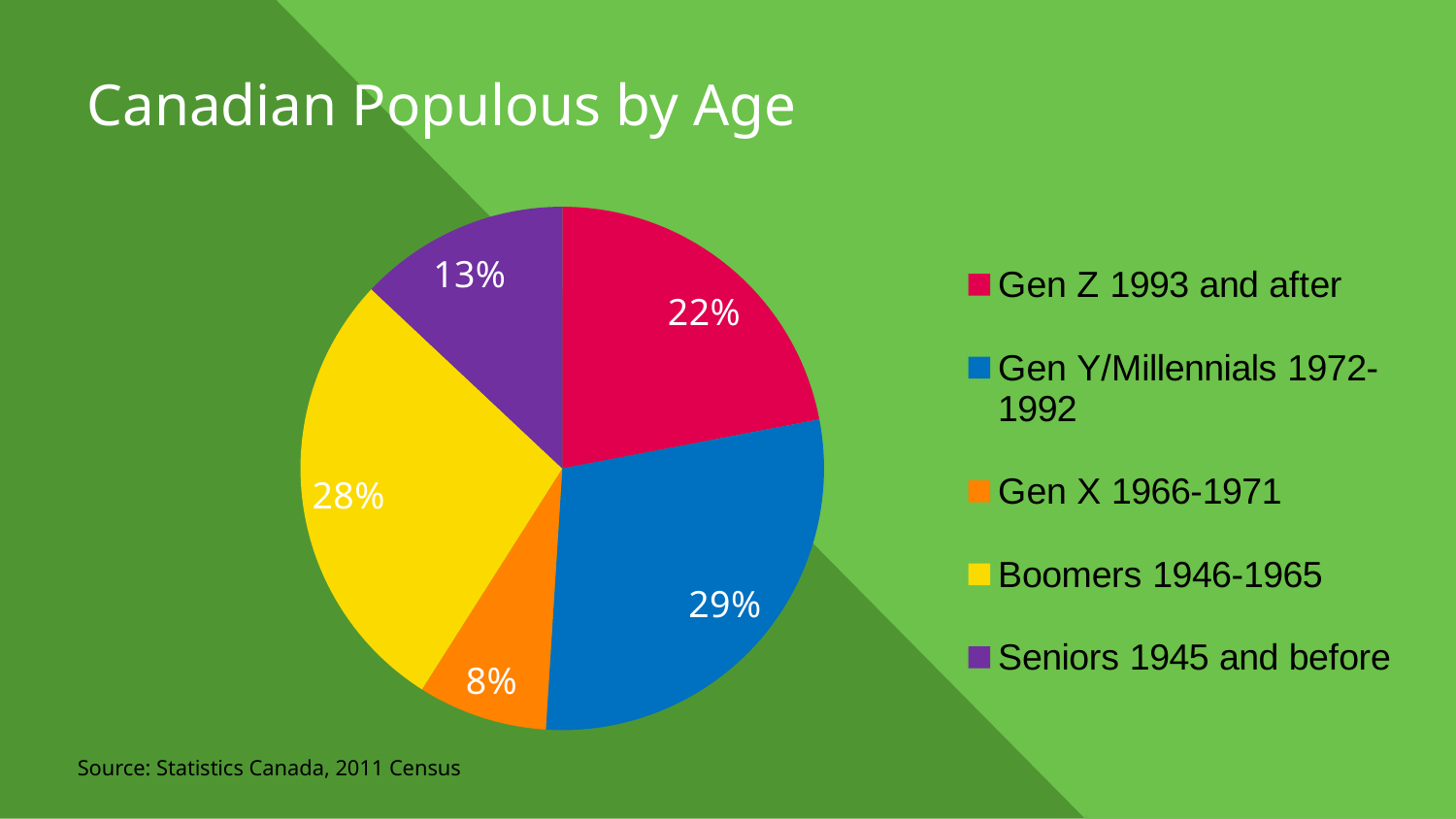
Which category has the largest share of the pie? Gen Y/Millennials 1972-1992 Which category has the smallest share of the pie? Gen X 1966-1971 What is the title of the chart? Canadian Populous by Age What is the difference between the shares for Gen Z 1993 and after and Seniors 1945 and before? 9% What is the value for Boomers 1946-1965? 28% What is the value for Seniors 1945 and before? 13% What kind of chart is shown on the slide? Pie chart What share of the pie does Gen Z 1993 and after represent? 22% Which is larger, the share for Gen Z 1993 and after or the share for Boomers 1946-1965? Boomers 1946-1965 What is the value for Gen Y/Millennials 1972-1992? 29% What is the value for Gen X 1966-1971? 8% How many categories does the legend list? 5